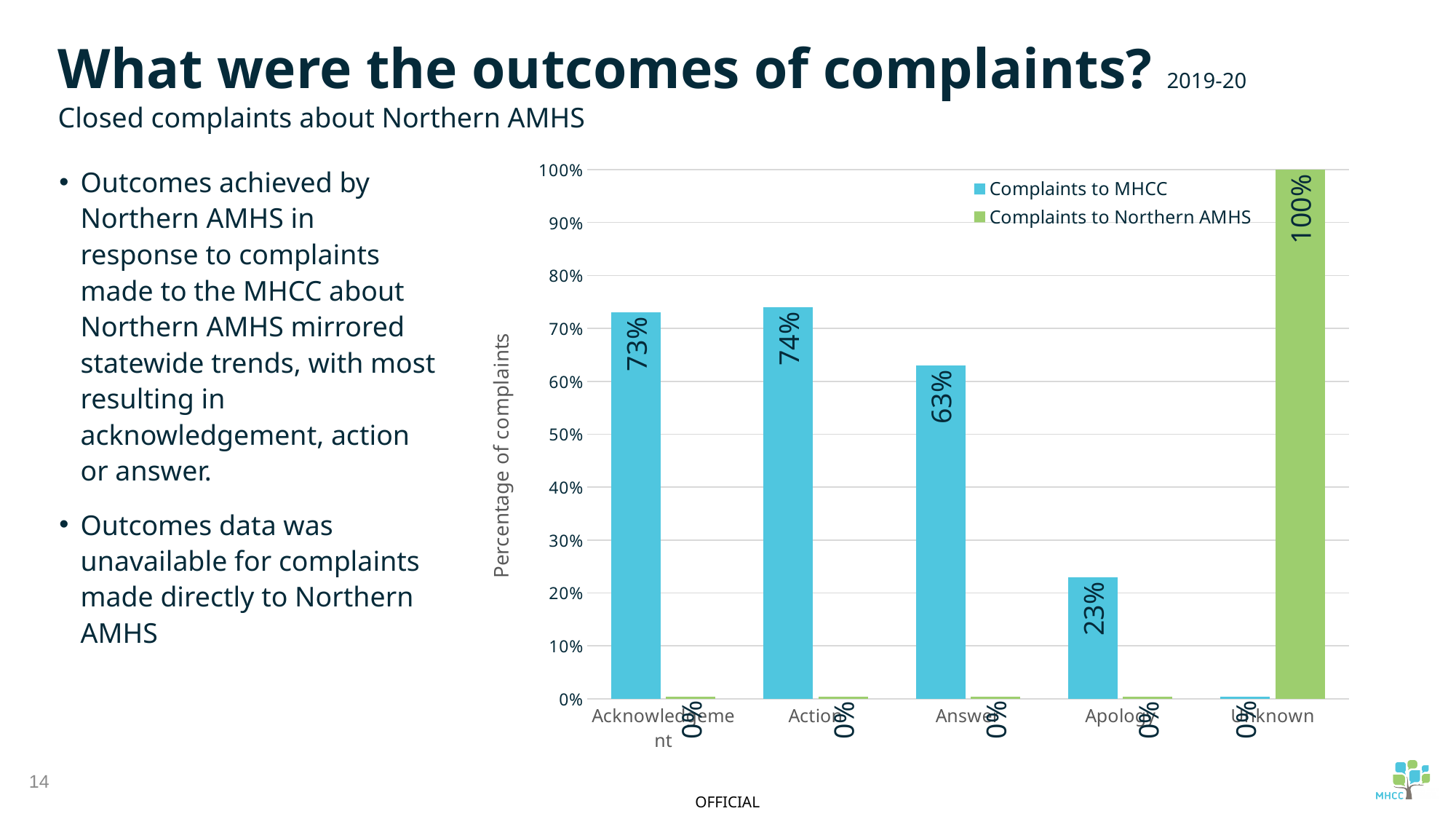
Which is larger for Complaints to MHCC: Acknowledgement or Answer? Acknowledgement What type of chart is shown on the slide? Bar chart How many series does the legend list? 2 What percentage of complaints to MHCC resulted in Action? 74% Which outcome category has the lowest value for Complaints to MHCC? Unknown What is the value for Complaints to Northern AMHS in the Unknown category? 100% How many outcome categories are shown on the x axis? 5 What percentage of complaints to MHCC resulted in Apology? 23% What is the difference between the Complaints to MHCC values for Answer and Apology? 40% What percentage of complaints to MHCC resulted in Acknowledgement? 73% What is the label of the y axis? Percentage of complaints Which outcome category has the highest value for Complaints to MHCC? Action